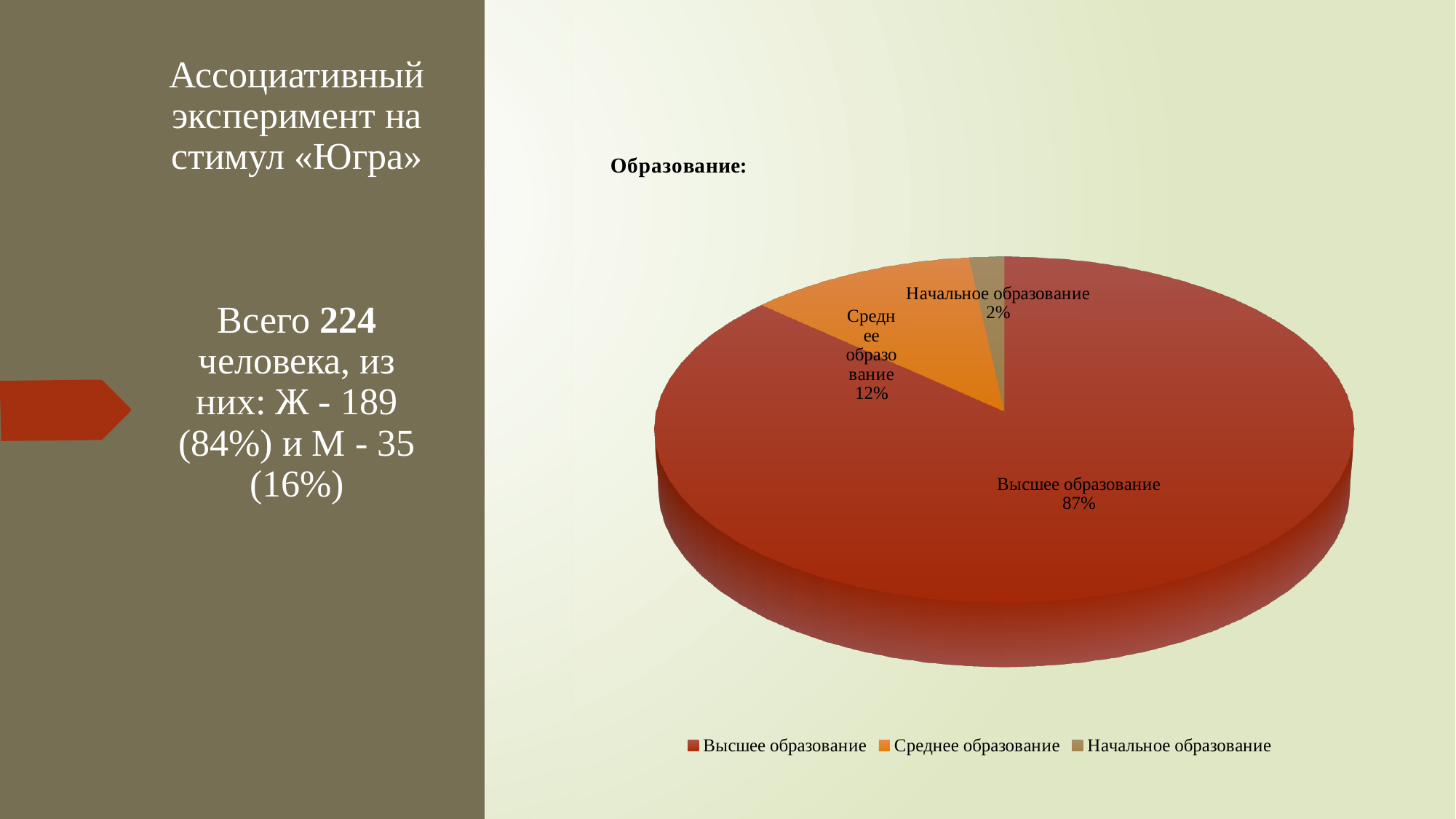
What is the difference in percentage points between Высшее образование and Среднее образование? 75 How many slices does the pie chart have? 3 What share of the pie does Среднее образование take? 12% Which is larger, the share for Среднее образование or for Начальное образование? Среднее образование How many entries does the legend list? 3 What share of the pie does Начальное образование take? 2% Which category has the largest slice of the pie? Высшее образование What colour is the slice for Среднее образование? orange What kind of chart is shown on the slide? pie chart What is the title of the chart? Образование: Which category has the smallest slice of the pie? Начальное образование What share of the pie does Высшее образование take? 87%